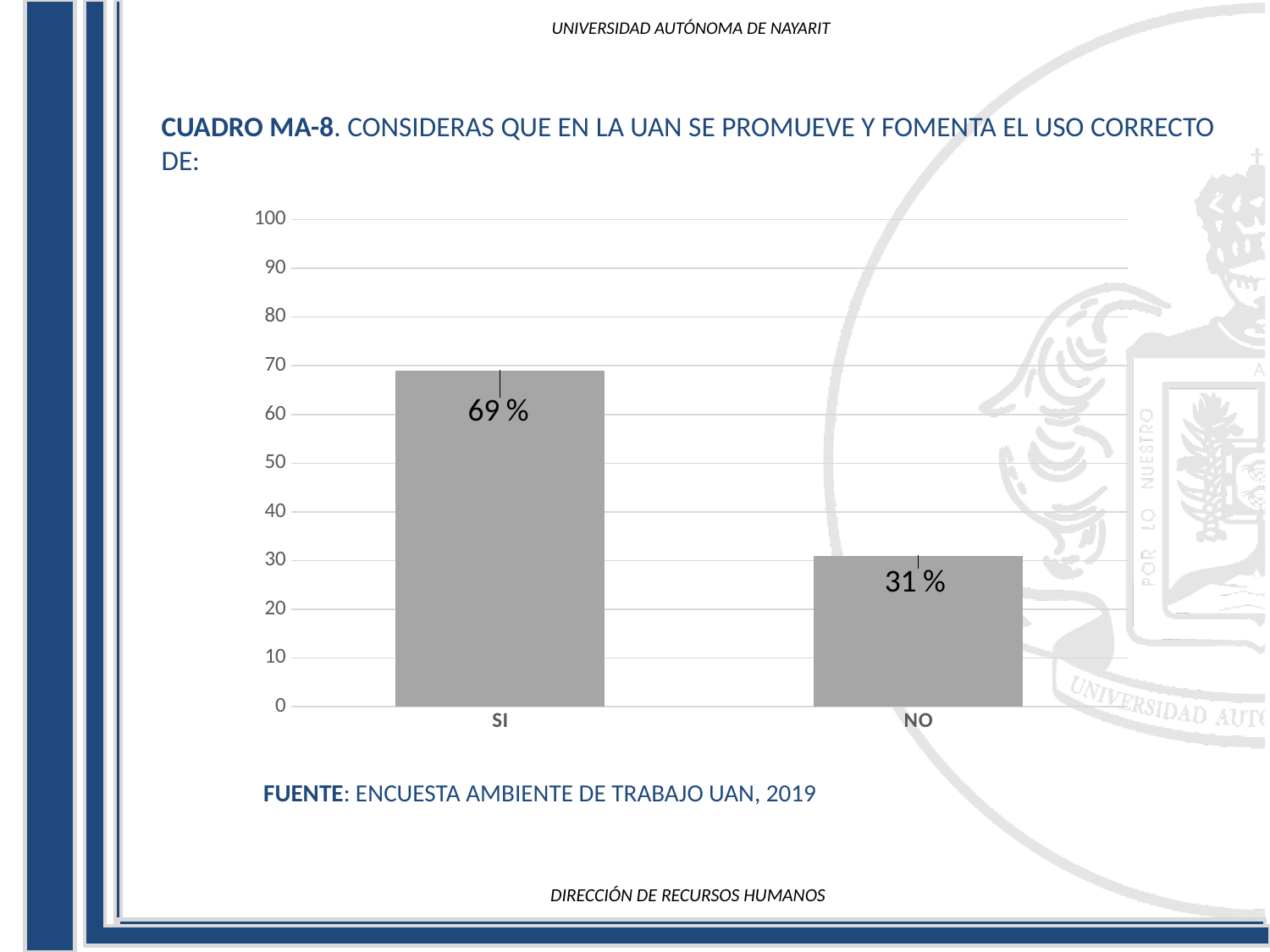
Which category has the highest value? SI What is the highest value shown on the y axis? 100 What source is cited below the chart? ENCUESTA AMBIENTE DE TRABAJO UAN, 2019 What kind of chart is shown on the slide? bar chart Which category has the lowest value? NO How many categories are shown on the x axis? 2 What is the value for SI? 69 % What is the value for NO? 31 % What is the difference between the values for SI and NO? 38 % Is the value for NO greater or less than 40? less Is the value for SI greater or less than 60? greater Which is larger, the value for SI or the value for NO? SI